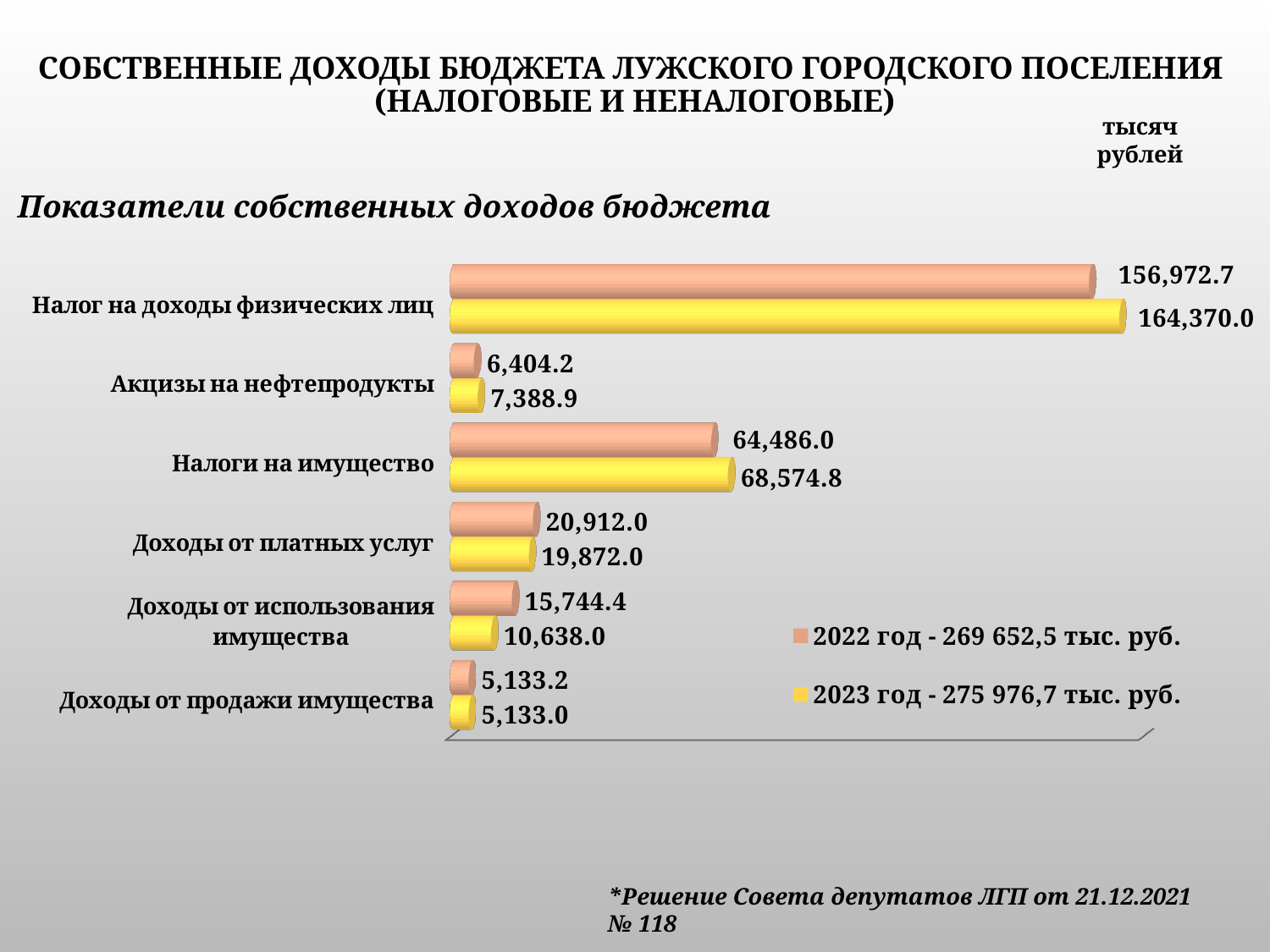
What is the difference between the 2023 and 2022 values for Налог на доходы физических лиц? 7,397.3 How many series does the legend list? 2 What is the 2022 value for Налоги на имущество? 64,486.0 Which category has the highest 2023 value? Налог на доходы физических лиц What is the 2022 value for Акцизы на нефтепродукты? 6,404.2 For Доходы от платных услуг, which year has the larger value, 2022 or 2023? 2022 What is the 2023 value for Налог на доходы физических лиц? 164,370.0 What is the difference between the 2022 and 2023 values for Доходы от использования имущества? 5,106.4 How many categories are shown on the chart? 6 Which category has the lowest 2022 value? Доходы от продажи имущества What type of chart is shown on the slide? Bar chart What is the 2023 value for Доходы от использования имущества? 10,638.0